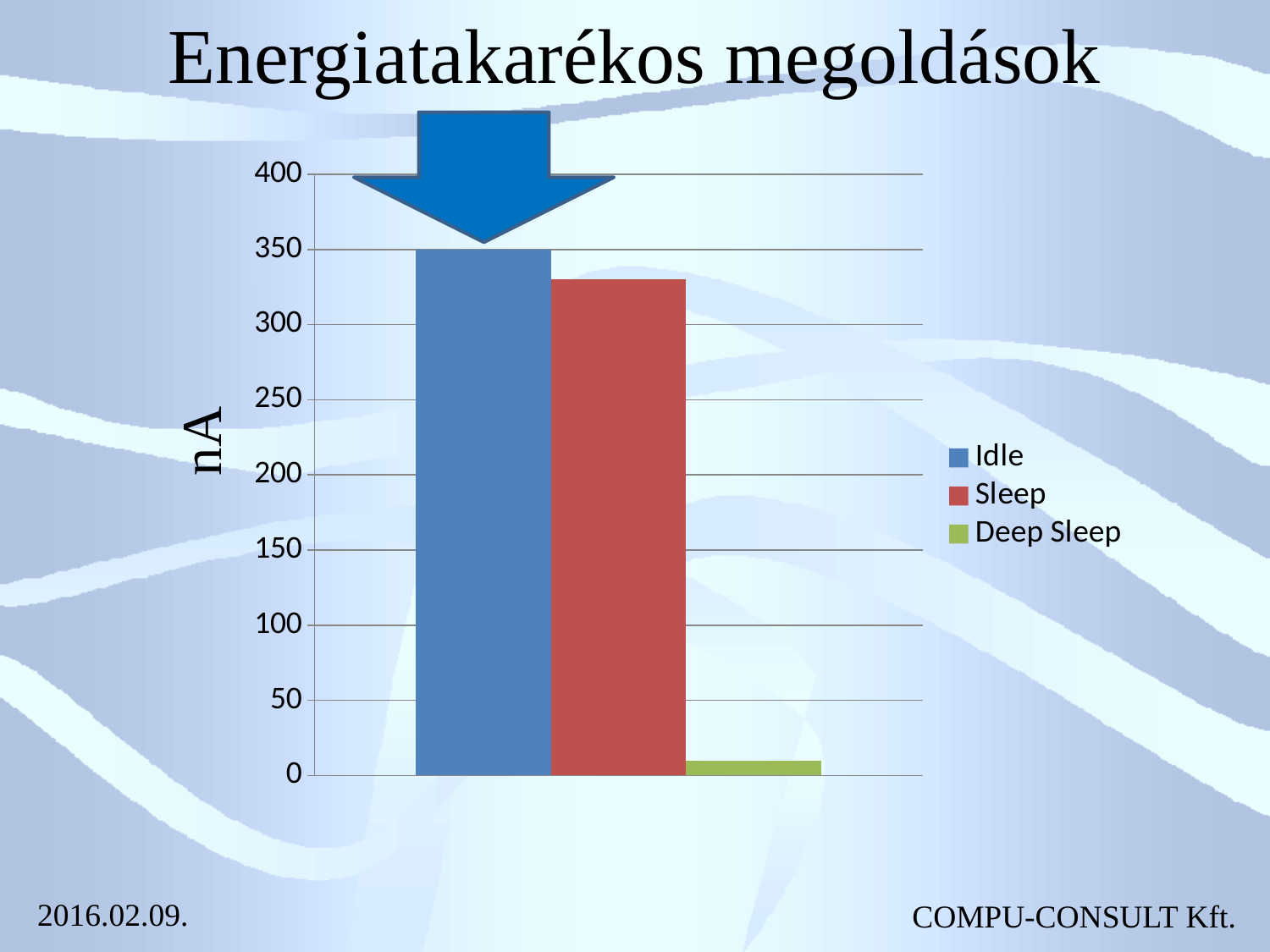
Is the value for Sleep greater or less than 350? less Which series has the lowest value? Deep Sleep Which series has the highest value? Idle Is the value for Sleep greater or less than 300? greater How many series does the legend list? 3 Which is larger, the value for Sleep or the value for Deep Sleep? Sleep Is the value for Deep Sleep greater or less than 50? less Which is larger, the value for Idle or the value for Sleep? Idle What kind of chart is shown on the slide? bar chart What unit is shown on the vertical axis label? nA What colour is the bar for Deep Sleep? green